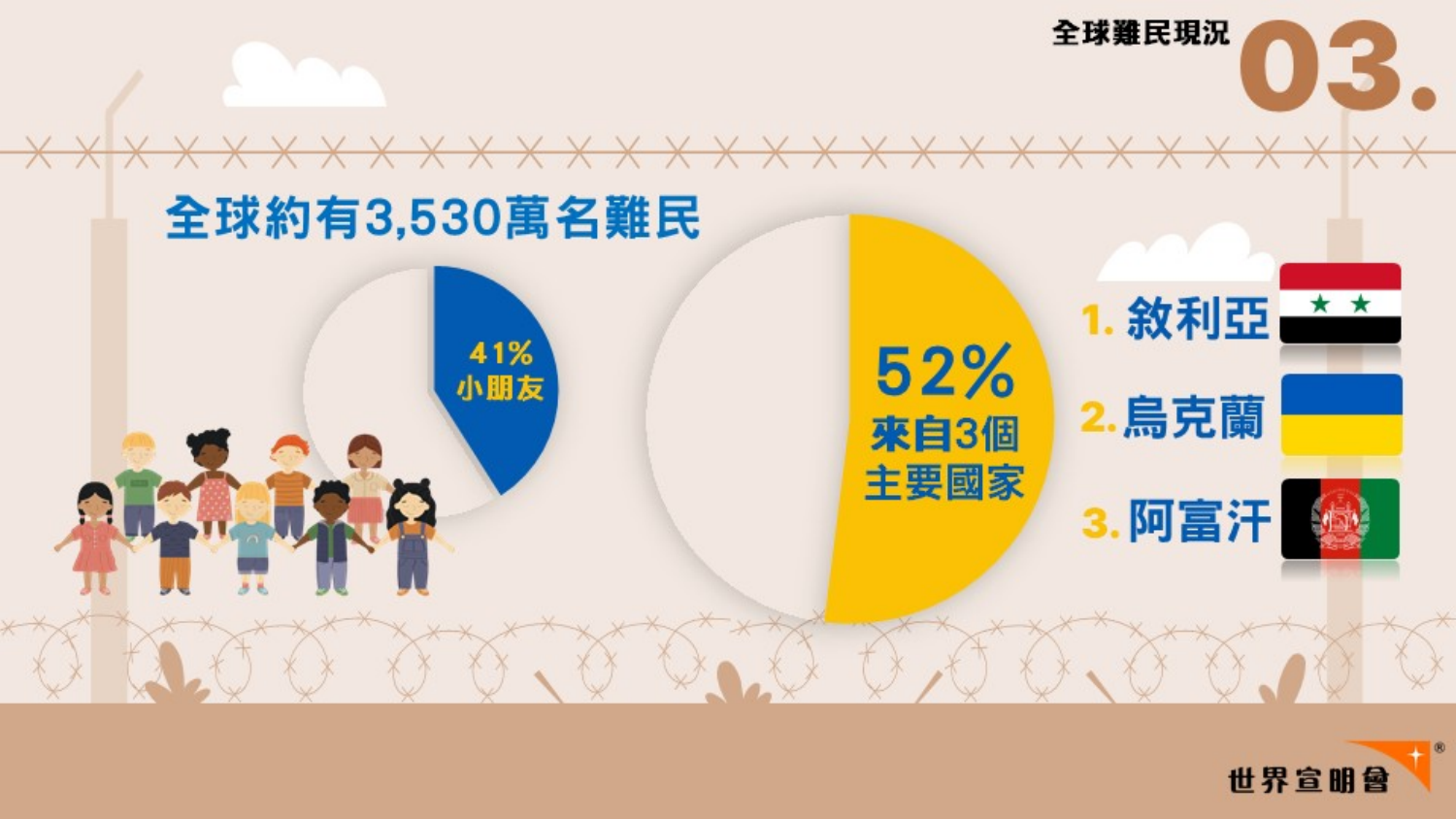
Is the 小朋友 share in the left pie chart greater or less than 50%? less What colour is the 52% slice in the centre pie chart? Yellow How many pie charts are on the slide? 2 How many main countries are listed next to the centre pie chart? 3 In the larger pie chart in the centre, what share of the pie is not from the 3 main countries? 48% In the larger pie chart in the centre, what share is labelled 來自3個主要國家? 52% Is the 來自3個主要國家 share in the centre pie chart greater or less than 50%? greater What kind of charts are shown on the slide? Pie charts In the smaller pie chart on the left, what share of the pie is not 小朋友? 59% Which is larger: the 小朋友 share in the left pie chart or the 來自3個主要國家 share in the centre pie chart? 來自3個主要國家 (52%) What is the difference between the 52% share in the centre pie chart and the 41% share in the left pie chart? 11 percentage points In the smaller pie chart on the left, what share is labelled 小朋友? 41%